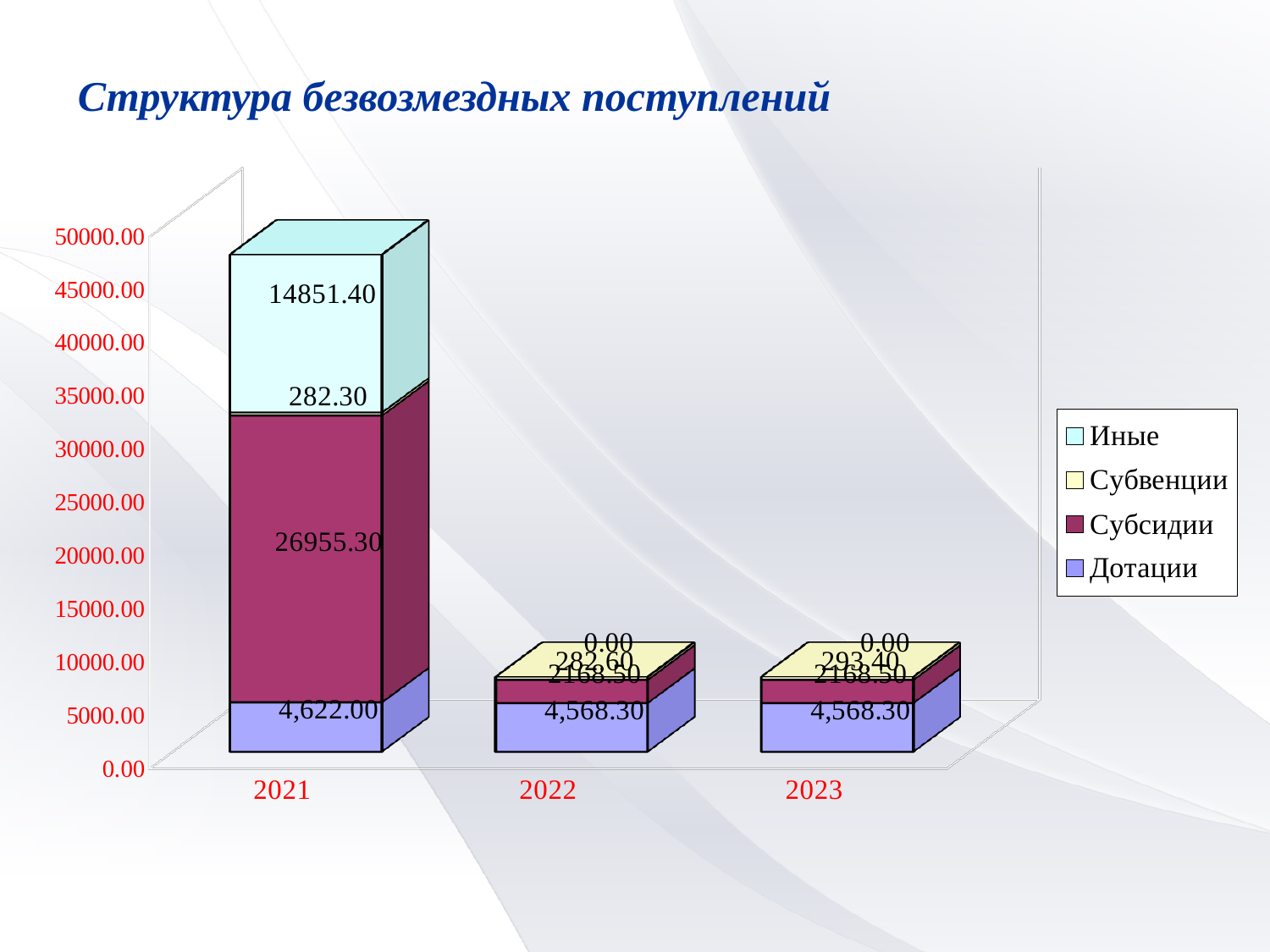
What is the value of Субсидии for 2021? 26955.30 What kind of chart is shown on the slide? Stacked bar chart How many series does the legend list? 4 Which is larger: Дотации in 2021 or Дотации in 2022? Дотации in 2021 What is the value of Субвенции for 2023? 293.40 What is the value of Иные for 2021? 14851.40 What is the value of Дотации for 2022? 4,568.30 Which year has the highest total stacked bar? 2021 How many years (categories) are shown on the x axis? 3 What is the difference between Субсидии in 2021 and Субсидии in 2022? 24786.80 What is the title of the chart? Структура безвозмездных поступлений Is the total of the 2021 stacked bar greater or less than 40000.00? greater